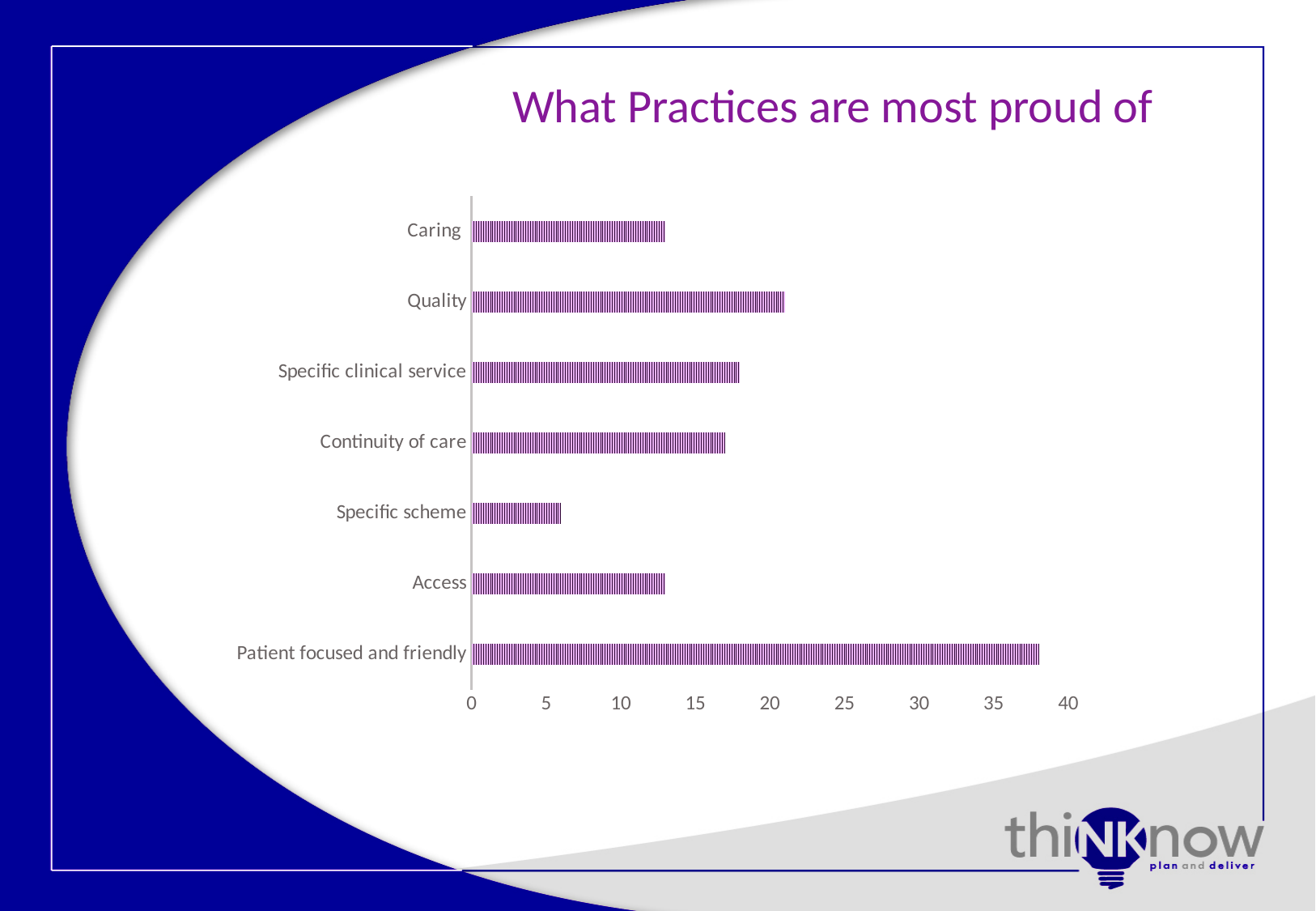
What kind of chart is shown on the slide? bar chart Is the value for Specific scheme greater or less than 10? less Is the value for Patient focused and friendly greater or less than 35? greater Which is larger, the value for Specific scheme or the value for Continuity of care? Continuity of care Which category has the lowest value? Specific scheme What is the title of the chart? What Practices are most proud of Which category has the highest value? Patient focused and friendly Is the value for Quality greater or less than 25? less Which is larger, the value for Quality or the value for Access? Quality How many categories are plotted in the chart? 7